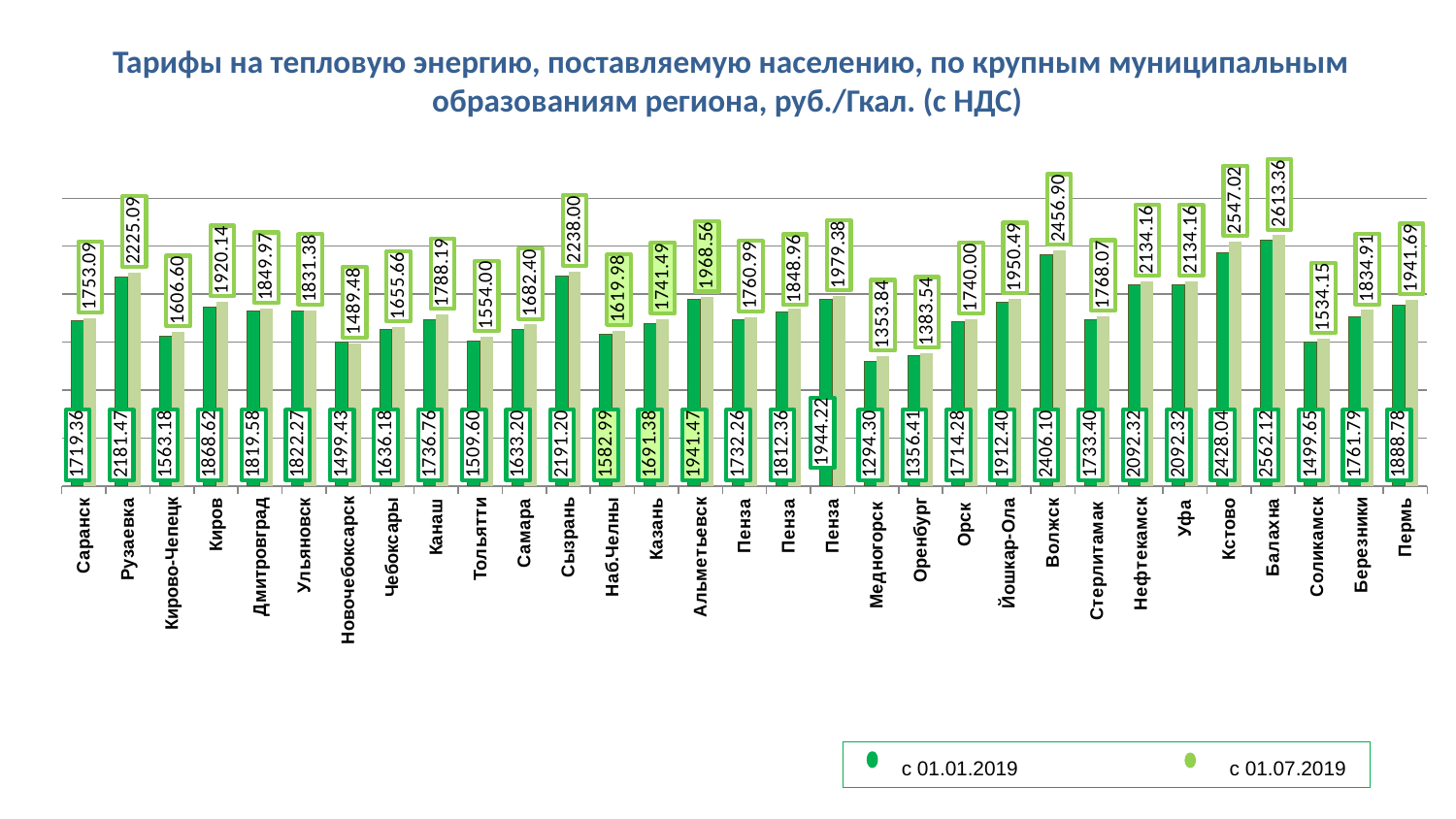
What kind of chart is shown on the slide? Bar chart What is the difference between the 'с 01.07.2019' and 'с 01.01.2019' tariffs for Балахна? 51.24 How many series does the legend list? 2 What is the difference between the 'с 01.07.2019' and 'с 01.01.2019' tariffs for Кстово? 118.98 What is the tariff for Волжск in the series 'с 01.07.2019'? 2456.90 How many municipalities (categories) are shown on the x axis? 31 Which has the larger tariff in the series 'с 01.01.2019': Сызрань or Рузаевка? Сызрань Which municipality has the highest tariff in the series 'с 01.07.2019'? Балахна What is the tariff for Тольятти in the series 'с 01.07.2019'? 1554.00 What are the two entries listed in the legend? с 01.01.2019 and с 01.07.2019 Which municipality has the lowest tariff in the series 'с 01.01.2019'? Медногорск What is the tariff for Саранск in the series 'с 01.01.2019'? 1719.36